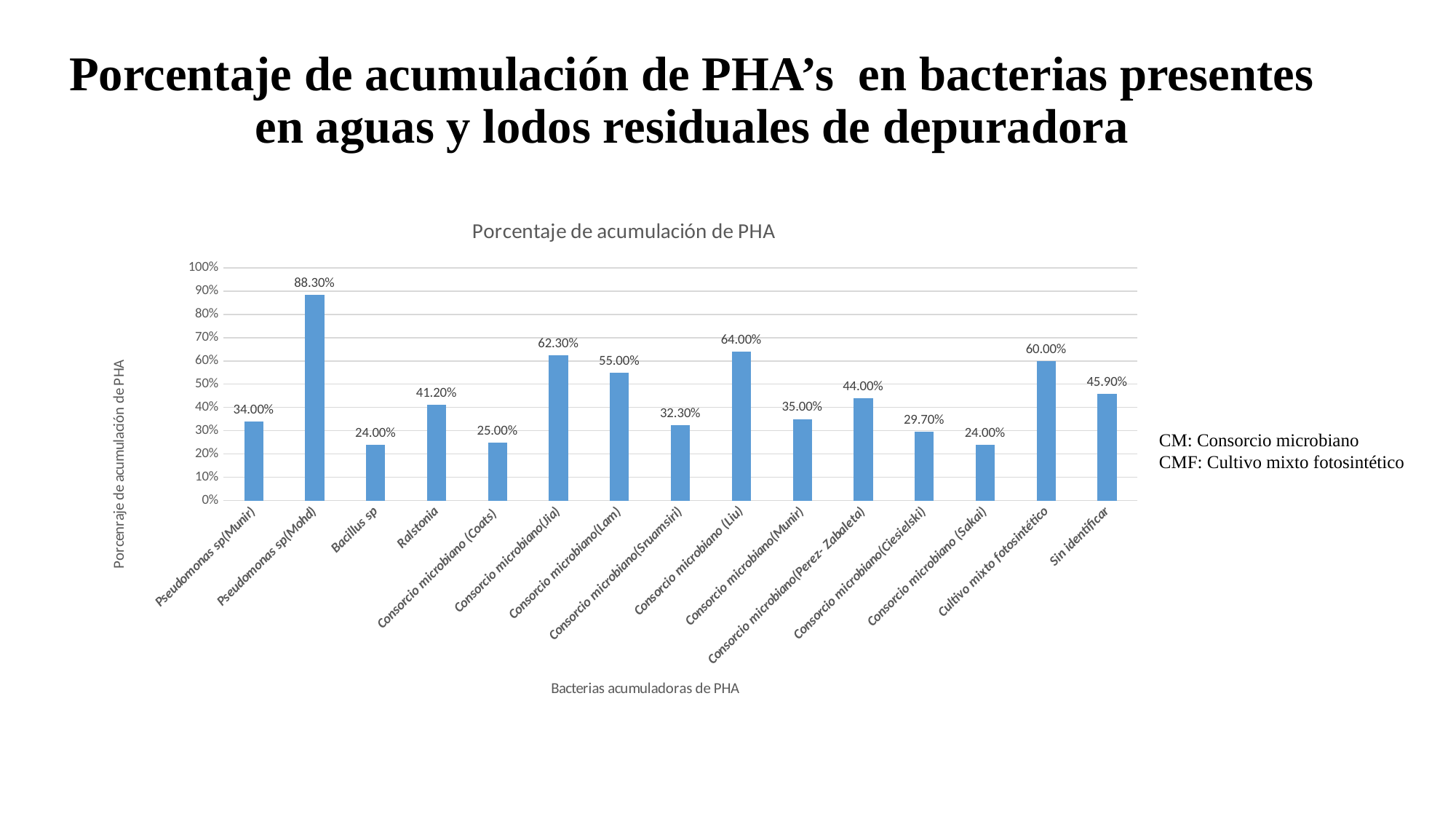
How many bacteria categories are plotted on the chart? 15 Which bacteria category has the highest PHA accumulation percentage? Pseudomonas sp(Mohd) What is the value shown for Cultivo mixto fotosintético? 60.00% What is the value shown for Consorcio microbiano (Liu)? 64.00% Which has a higher value, Consorcio microbiano(Jia) or Consorcio microbiano(Lam)? Consorcio microbiano(Jia) What is the label of the x axis of the chart? Bacterias acumuladoras de PHA What type of chart is shown on the slide? Bar chart What is the PHA accumulation percentage for Pseudomonas sp(Mohd)? 88.30% What is the value shown for Ralstonia? 41.20% What is the lowest PHA accumulation percentage shown on the chart? 24.00% What is the difference in percentage points between Cultivo mixto fotosintético and Sin identificar? 14.10 percentage points What is the difference in percentage points between Pseudomonas sp(Mohd) and Consorcio microbiano (Liu)? 24.30 percentage points